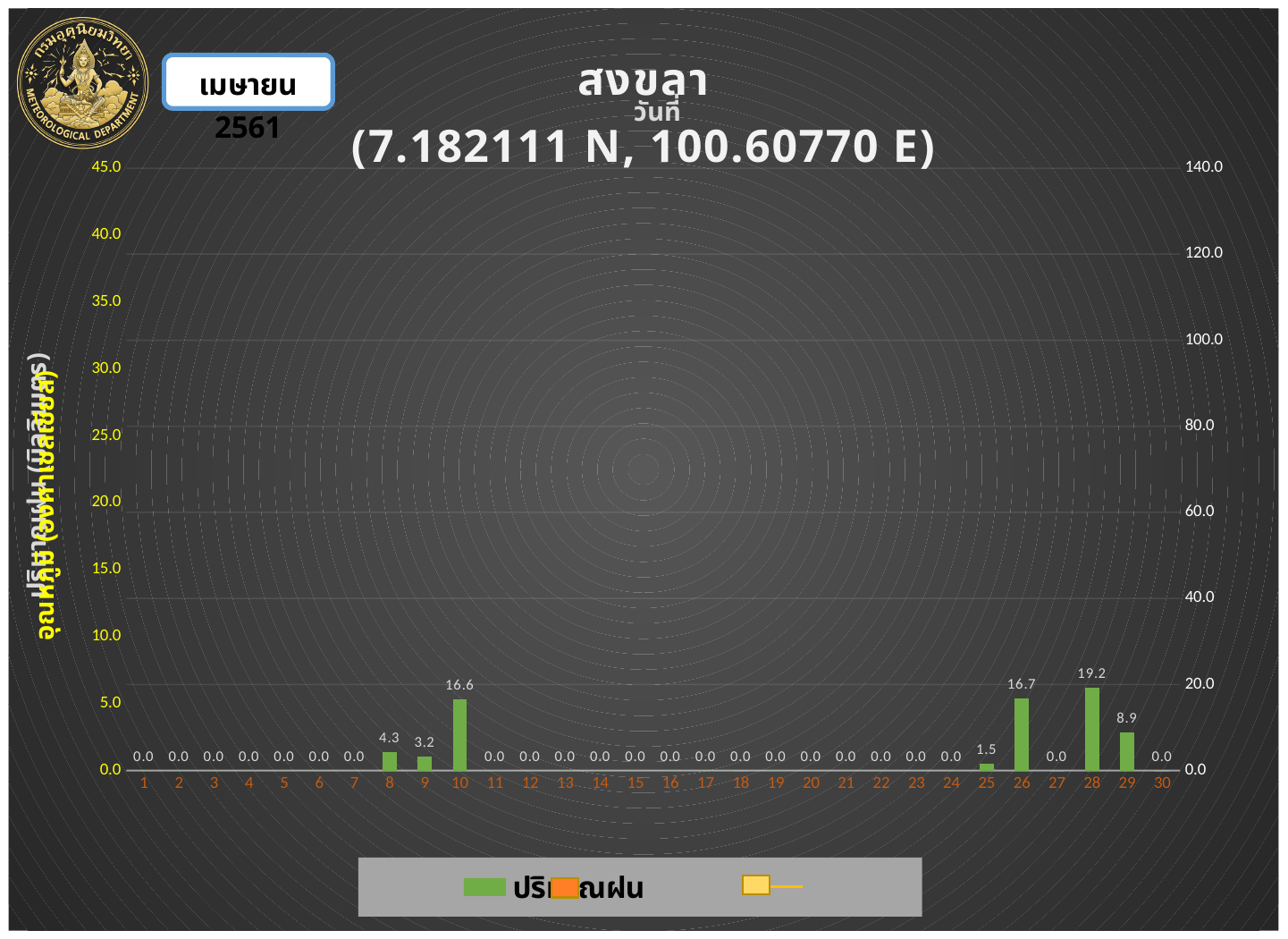
Which day has the highest rainfall value? 28 What is the rainfall value shown for day 28? 19.2 What is the difference between the rainfall values for day 10 and day 9? 13.4 What kind of chart is shown on the slide? bar chart How many days are shown on the x axis? 30 Which is larger, the rainfall value for day 26 or for day 29? day 26 What is the rainfall value shown for day 8? 4.3 What is the rainfall value shown for day 10? 16.6 What is the rainfall value shown for day 25? 1.5 Which is larger, the rainfall value for day 8 or for day 9? day 8 What is the difference between the rainfall values for day 28 and day 26? 2.5 What are the coordinates given in the chart title? 7.182111 N, 100.60770 E